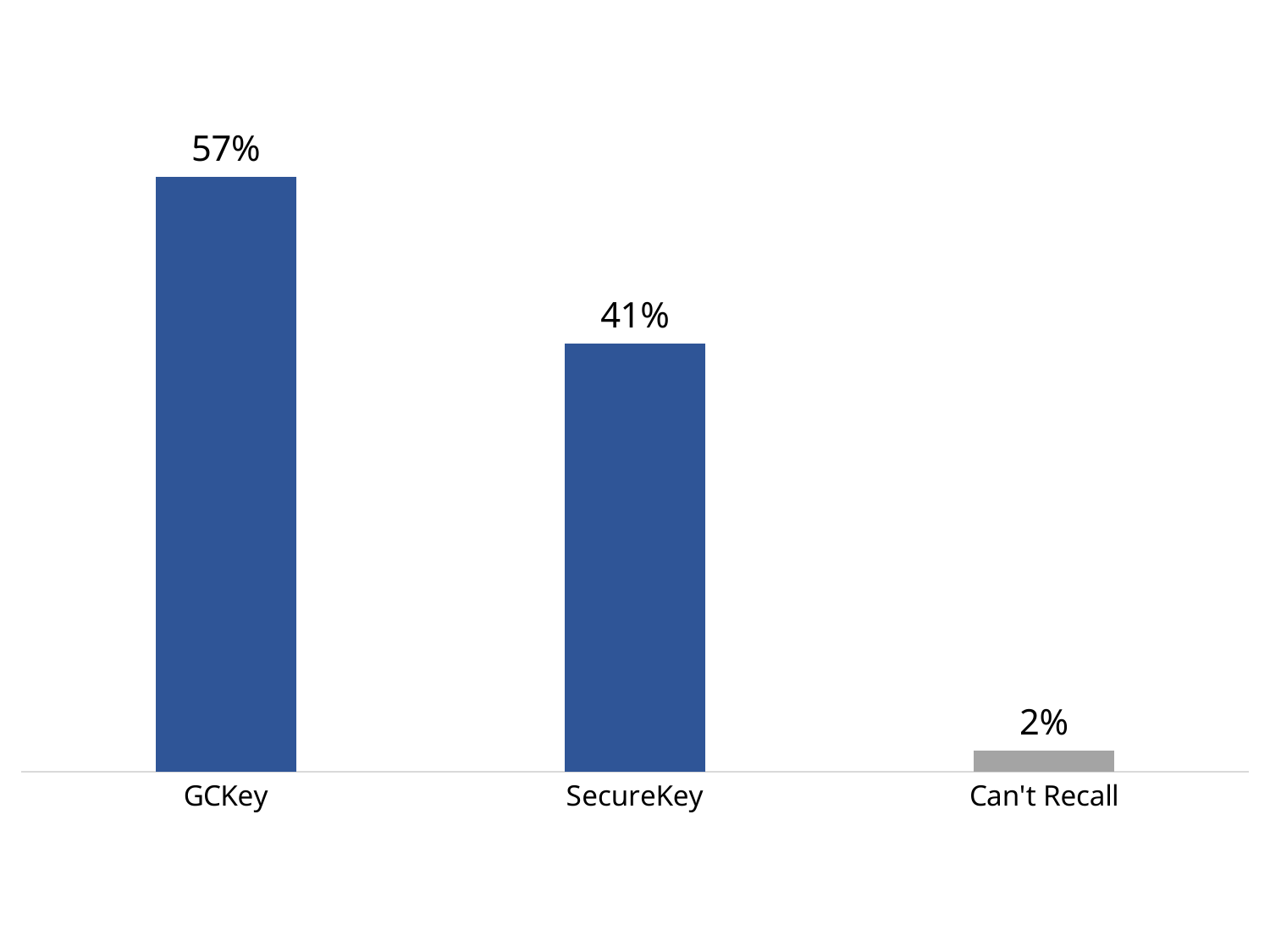
What is the value for Can't Recall? 2% What is the value for GCKey? 57% What is the difference between the values for GCKey and SecureKey? 16% How many categories are shown in the chart? 3 What is the difference between the values for SecureKey and Can't Recall? 39% What is the value for SecureKey? 41% What kind of chart is shown on the slide? Bar chart Which category has the highest value? GCKey Do the values rise or fall from left to right across the categories? Fall Which bar is coloured grey rather than blue? Can't Recall Which category has the lowest value? Can't Recall Which is larger, the value for GCKey or the value for SecureKey? GCKey